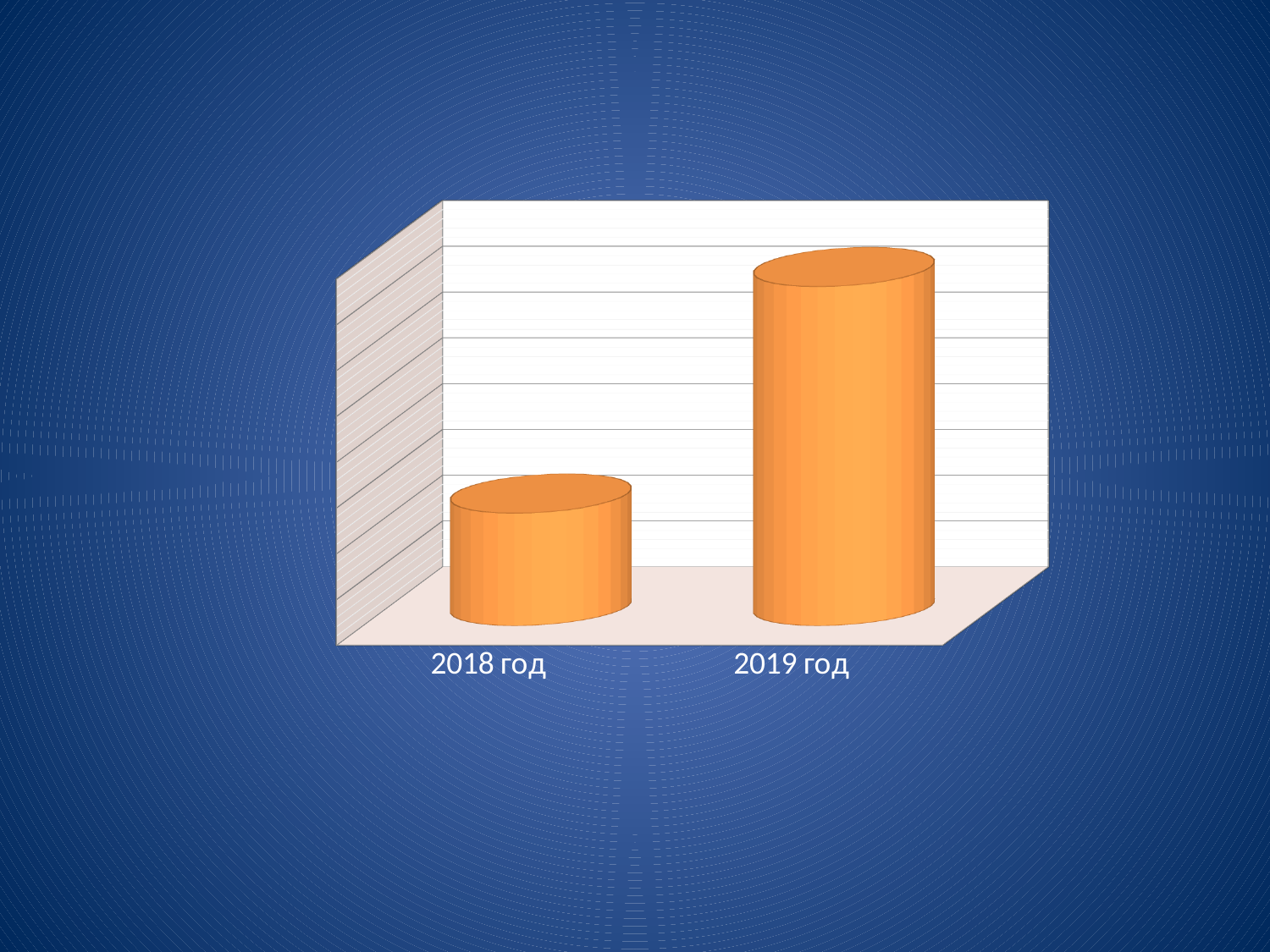
Which category has the lowest value in the chart? 2018 год What is the label of the first category on the x axis? 2018 год What colour are the bars in the chart? orange What kind of chart is shown on the slide? bar chart Do the values rise or fall from 2018 год to 2019 год? rise Which is larger, the value for 2018 год or the value for 2019 год? 2019 год Which category has the highest value in the chart? 2019 год How many categories are shown on the x axis of the chart? 2